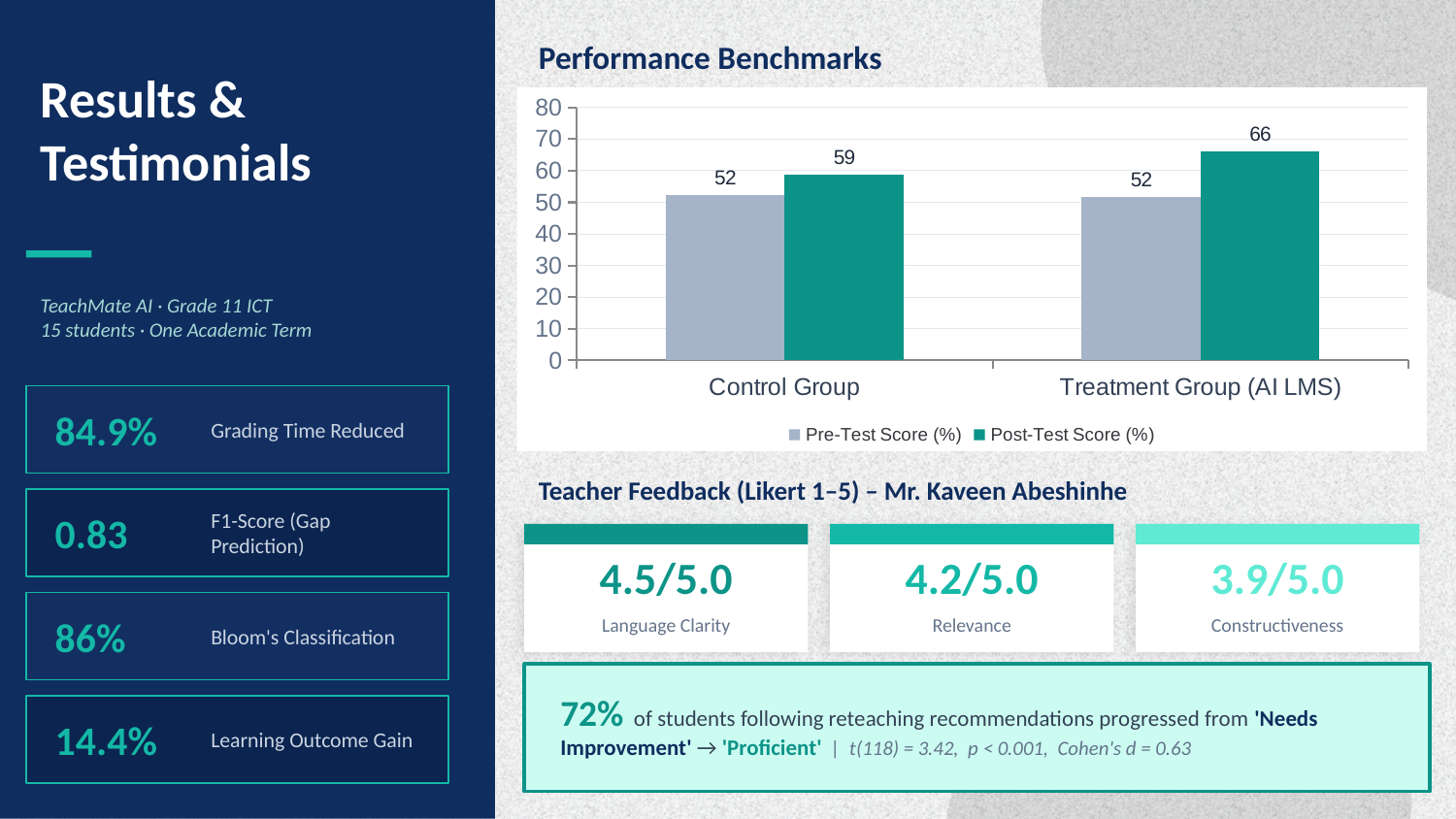
What is the Post-Test Score (%) for the Treatment Group (AI LMS)? 66 What kind of chart is the Performance Benchmarks chart? Bar chart What is the title of the chart on the slide? Performance Benchmarks Is the Post-Test Score (%) for the Treatment Group (AI LMS) greater or less than 60? greater What is the Post-Test Score (%) for the Control Group? 59 Is the Post-Test Score (%) for the Control Group larger than the Pre-Test Score (%) for the Control Group? Yes What is the Pre-Test Score (%) for the Control Group? 52 What is the difference between the Post-Test Score (%) of the Treatment Group (AI LMS) and the Control Group? 7 Which group has the higher Post-Test Score (%)? Treatment Group (AI LMS) What is the difference between the Pre-Test and Post-Test Score (%) for the Treatment Group (AI LMS)? 14 How many series does the legend of the Performance Benchmarks chart list? 2 How many groups are shown on the x axis of the Performance Benchmarks chart? 2